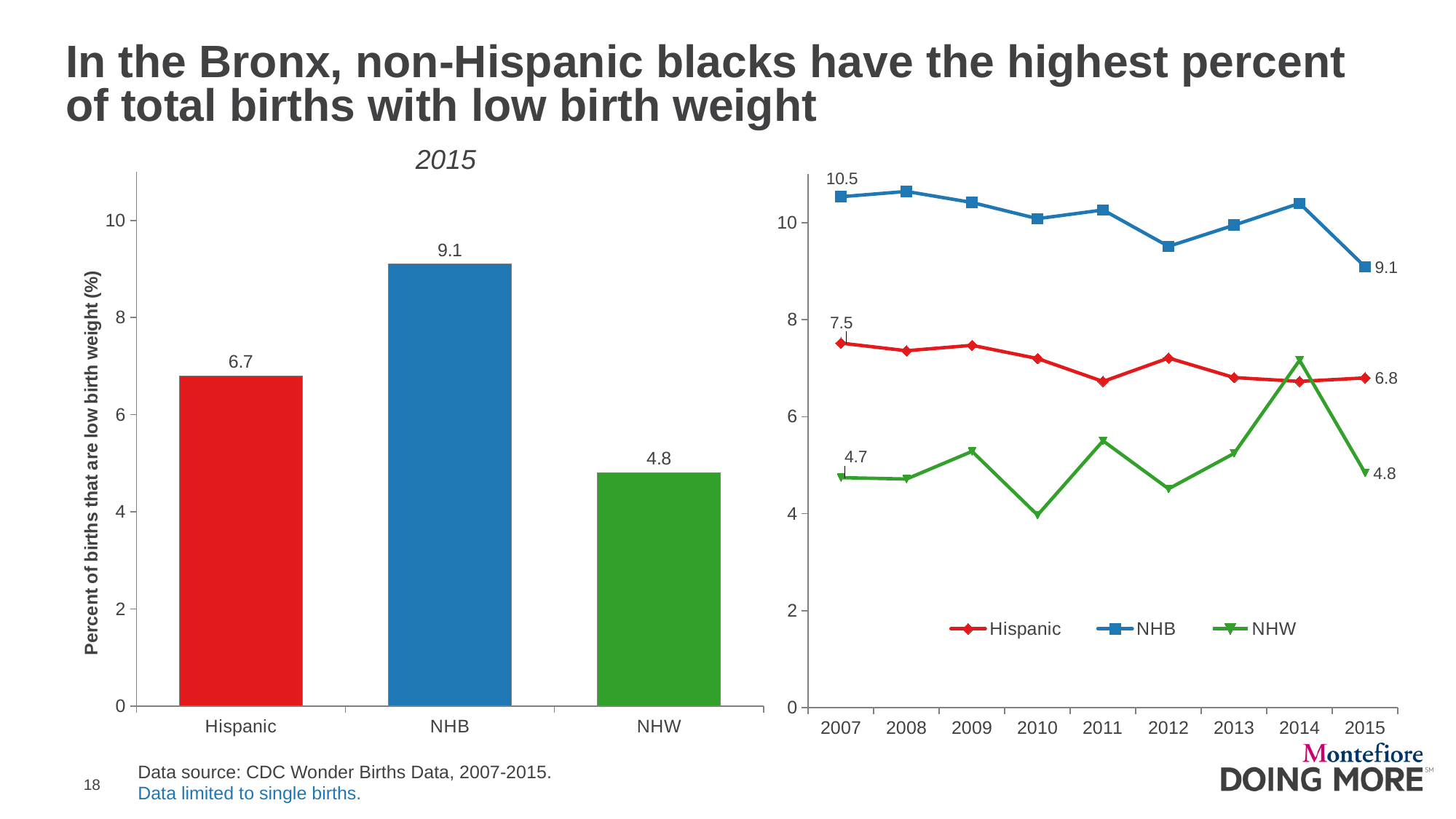
In the line chart on the right, what is the Hispanic value in 2015? 6.8 In the line chart on the right, how many series does the legend list? 3 In the line chart on the right, does the NHB series rise or fall from 2007 to 2015? Fall What kind of chart is the chart on the left of the slide? Bar chart In the 2015 bar chart, what is the difference between the NHB and NHW values? 4.3 In the line chart on the right, which series is shown in green? NHW In the line chart on the right, what is the NHB value in 2007? 10.5 In the 2015 bar chart, how many categories are shown? 3 In the 2015 bar chart, what is the value for NHB? 9.1 In the 2015 bar chart, what is the value for Hispanic? 6.7 In the 2015 bar chart, which category has the lowest value? NHW